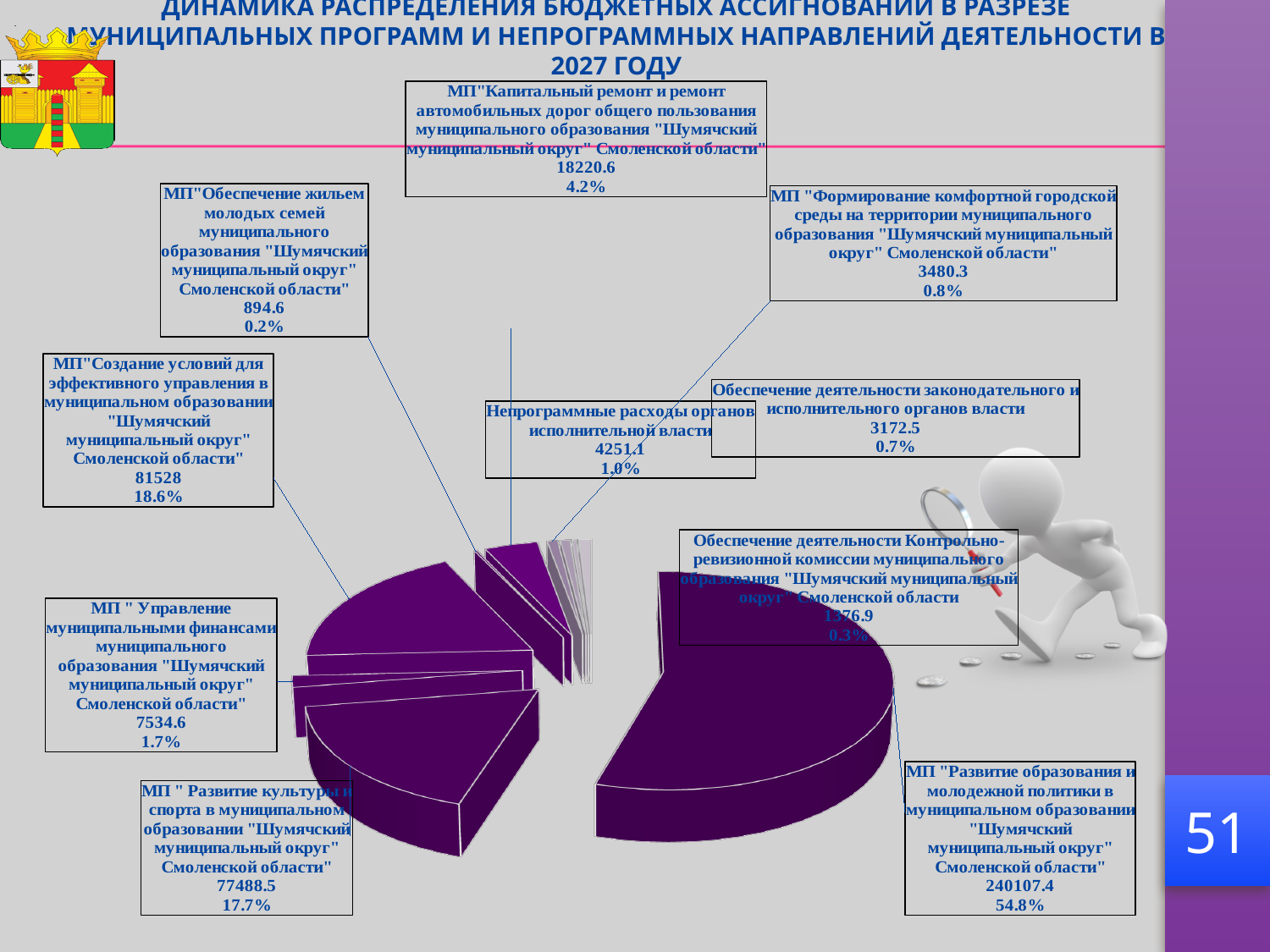
Which is larger: МП "Капитальный ремонт и ремонт автомобильных дорог" or МП "Управление муниципальными финансами"? МП "Капитальный ремонт и ремонт автомобильных дорог" Which category has the largest value on the pie chart? МП "Развитие образования и молодежной политики" What kind of chart is shown on the slide? Pie chart Which category has the smallest value on the pie chart? МП "Обеспечение жильем молодых семей" What is the value for МП "Развитие культуры и спорта"? 77488.5 What share of the pie does МП "Развитие образования и молодежной политики" represent? 54.8% What is the value for Непрограммные расходы органов исполнительной власти? 4251.1 What is the difference in percentage share between МП "Создание условий для эффективного управления" and МП "Развитие культуры и спорта"? 0.9% What is the value for МП "Развитие образования и молодежной политики"? 240107.4 What year does the chart title refer to? 2027 How many categories (slices) are labelled on the pie chart? 10 What share of the pie does МП "Создание условий для эффективного управления" represent? 18.6%